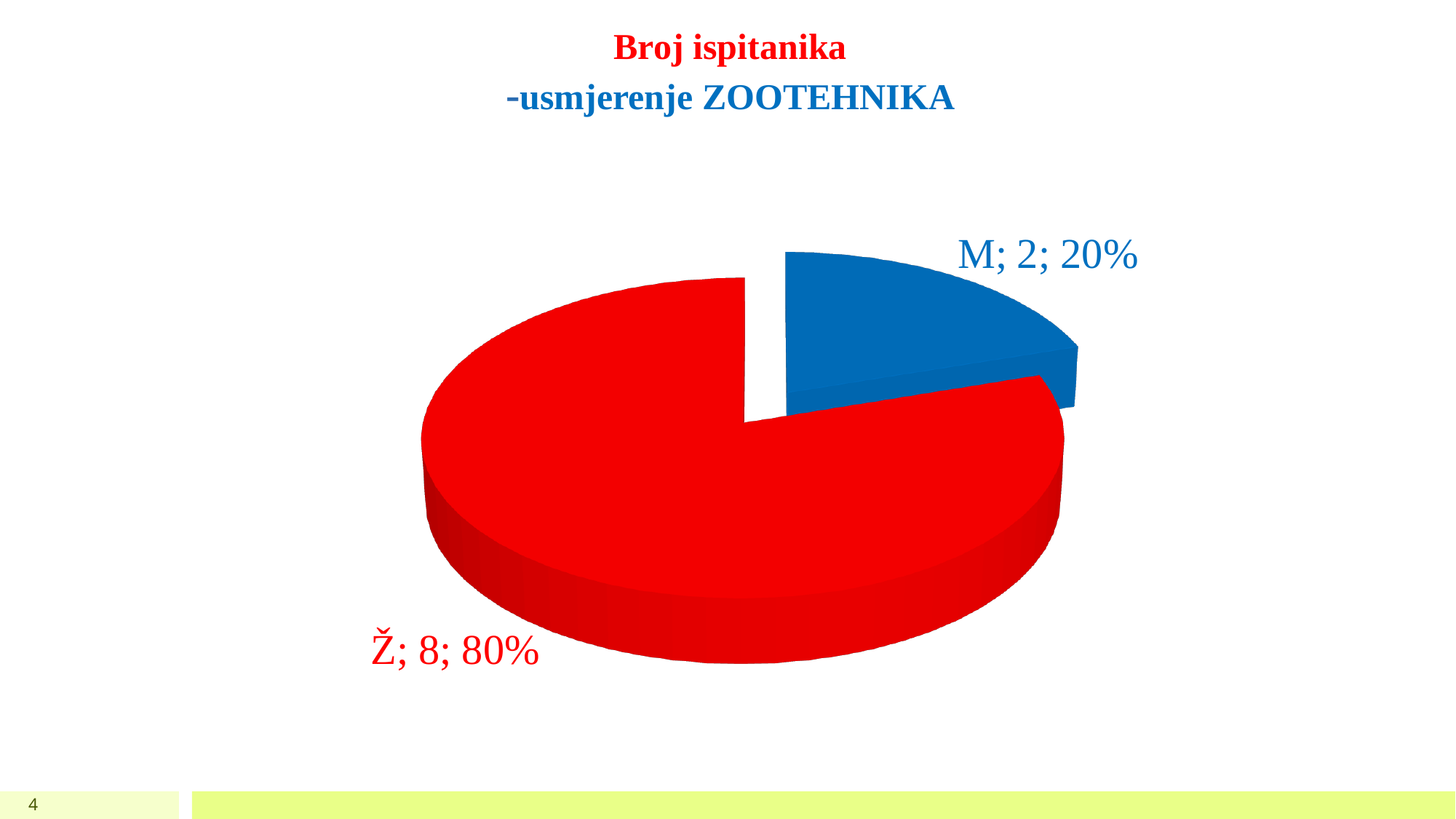
Which is larger, the value for Ž or the value for M? Ž Which category has the largest slice in the pie chart? Ž What share of the pie does the M slice represent? 20% What share of the pie does the Ž slice represent? 80% What colour is the M slice in the pie chart? blue What is the value for M in the pie chart? 2 How many slices does the pie chart have? 2 What is the total of the values shown in the pie chart? 10 What is the difference between the values for Ž and M? 6 What kind of chart is shown on the slide? pie chart Which category has the smallest slice in the pie chart? M What is the value for Ž in the pie chart? 8